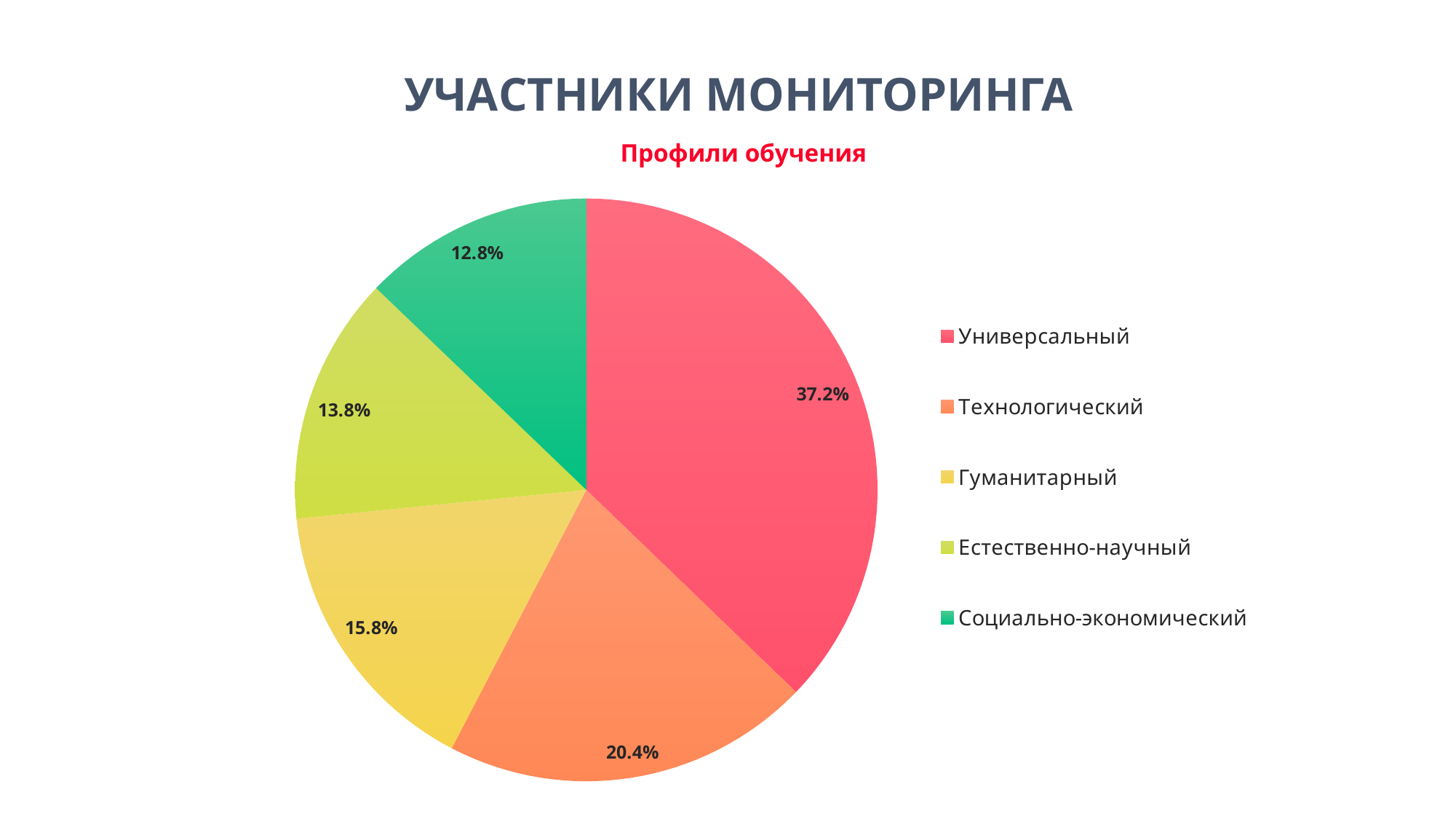
What is the title of the chart? Профили обучения How many slices does the pie chart have? 5 What share of the pie does Естественно-научный have? 13.8% What type of chart is shown on the slide? pie chart Which profile has the smallest share of the pie? Социально-экономический What is the difference in percentage points between Универсальный and Технологический? 16.8 What share of the pie does Универсальный have? 37.2% Which is larger, the share for Гуманитарный or the share for Естественно-научный? Гуманитарный What share of the pie does Гуманитарный have? 15.8% Which profile has the largest share of the pie? Универсальный What share of the pie does Социально-экономический have? 12.8% What share of the pie does Технологический have? 20.4%